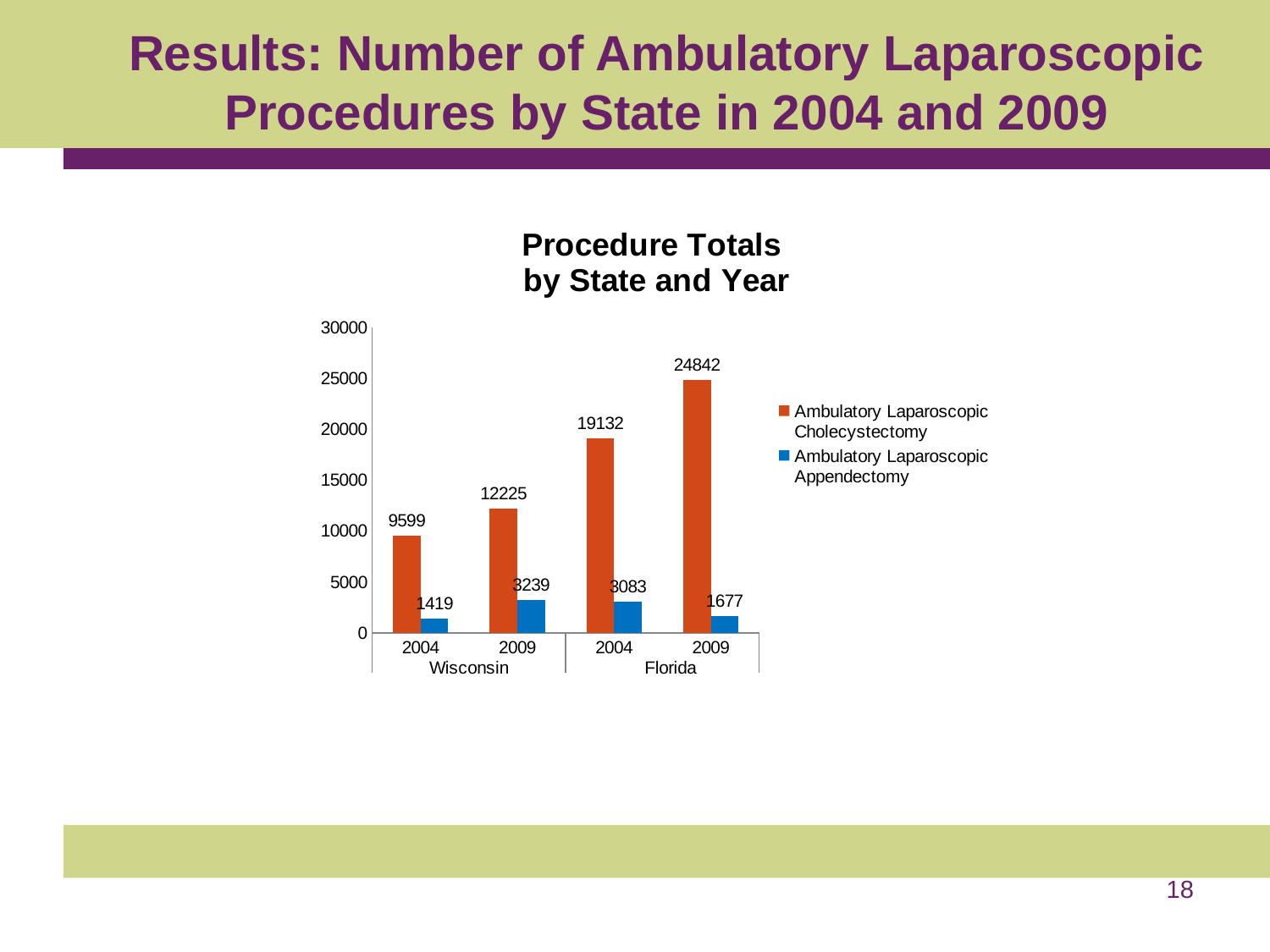
Which state and year has the lowest Ambulatory Laparoscopic Appendectomy value? Wisconsin 2004 What is the value for Ambulatory Laparoscopic Cholecystectomy in Wisconsin in 2004? 9599 What is the title of the chart? Procedure Totals by State and Year Which state and year has the highest Ambulatory Laparoscopic Cholecystectomy value? Florida 2009 What is the difference between the Ambulatory Laparoscopic Cholecystectomy values for Wisconsin in 2009 and 2004? 2626 What kind of chart is shown? bar chart What is the value for Ambulatory Laparoscopic Appendectomy in Florida in 2009? 1677 How many series does the legend list? 2 What is the value for Ambulatory Laparoscopic Cholecystectomy in Florida in 2009? 24842 How many state-year categories are shown on the x axis? 4 Which is larger: Ambulatory Laparoscopic Appendectomy in Wisconsin 2009 or in Florida 2004? Wisconsin 2009 Is the Ambulatory Laparoscopic Cholecystectomy value for Florida in 2004 greater or less than 15000? greater